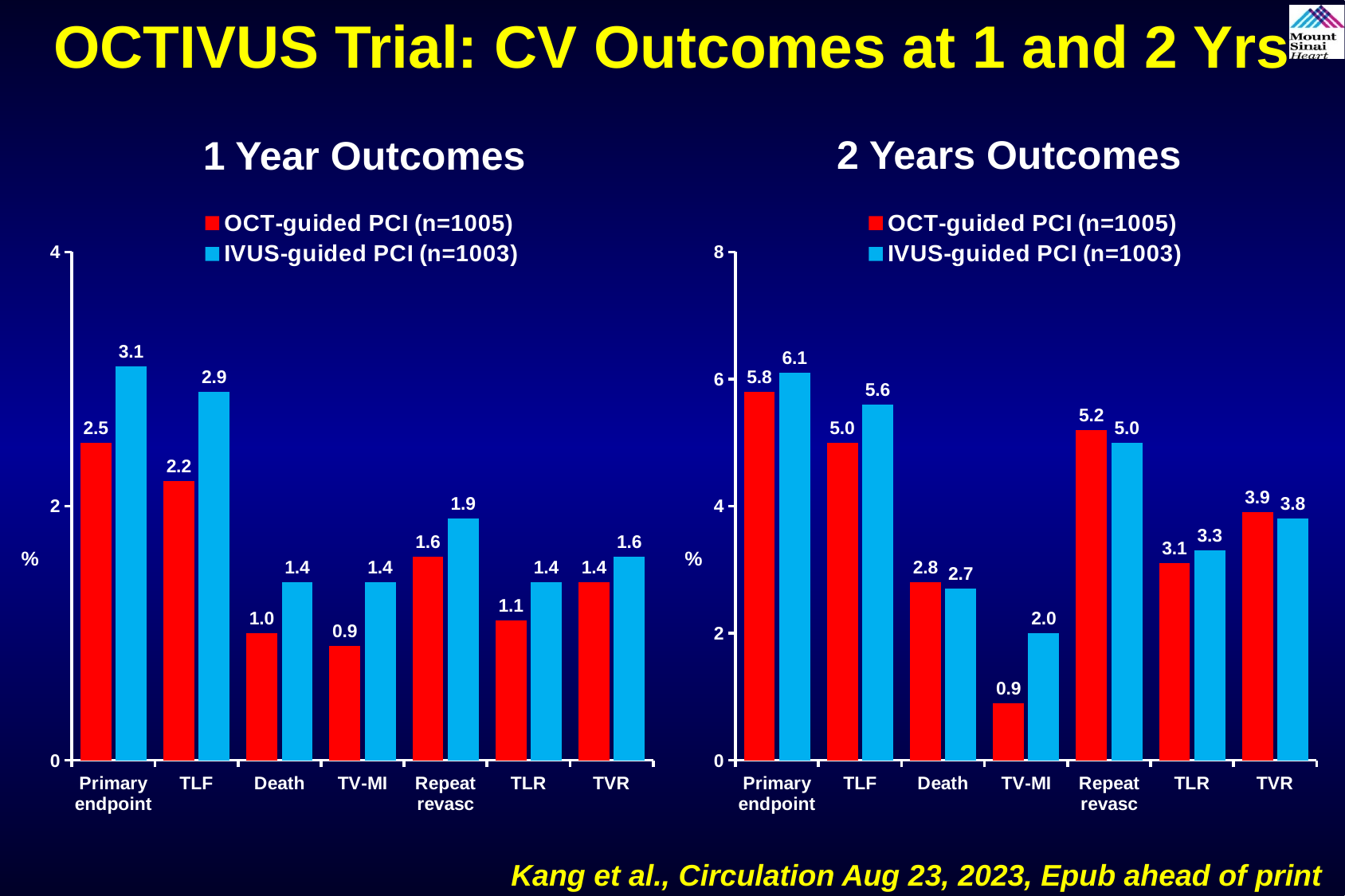
In the 1 Year Outcomes chart, what is the value for OCT-guided PCI at the Primary endpoint? 2.5 In the 2 Years Outcomes chart, which is larger for Repeat revasc: OCT-guided PCI or IVUS-guided PCI? OCT-guided PCI In the 2 Years Outcomes chart, what is the value for IVUS-guided PCI for TLF? 5.6 In the 1 Year Outcomes chart, which category has the highest IVUS-guided PCI value? Primary endpoint What kind of chart is the 1 Year Outcomes chart? Bar chart In the 2 Years Outcomes chart, what is the difference between the OCT-guided PCI and IVUS-guided PCI values for the Primary endpoint? 0.3 How many categories are shown on the x axis of the 1 Year Outcomes chart? 7 In the 1 Year Outcomes chart, what is the difference between the IVUS-guided PCI and OCT-guided PCI values for TLF? 0.7 How many series does the legend of the 2 Years Outcomes chart list? 2 In the 2 Years Outcomes chart, is the IVUS-guided PCI value for TV-MI greater or less than 4? less What colour represents OCT-guided PCI in the legend of the 1 Year Outcomes chart? Red In the 2 Years Outcomes chart, which category has the lowest OCT-guided PCI value? TV-MI